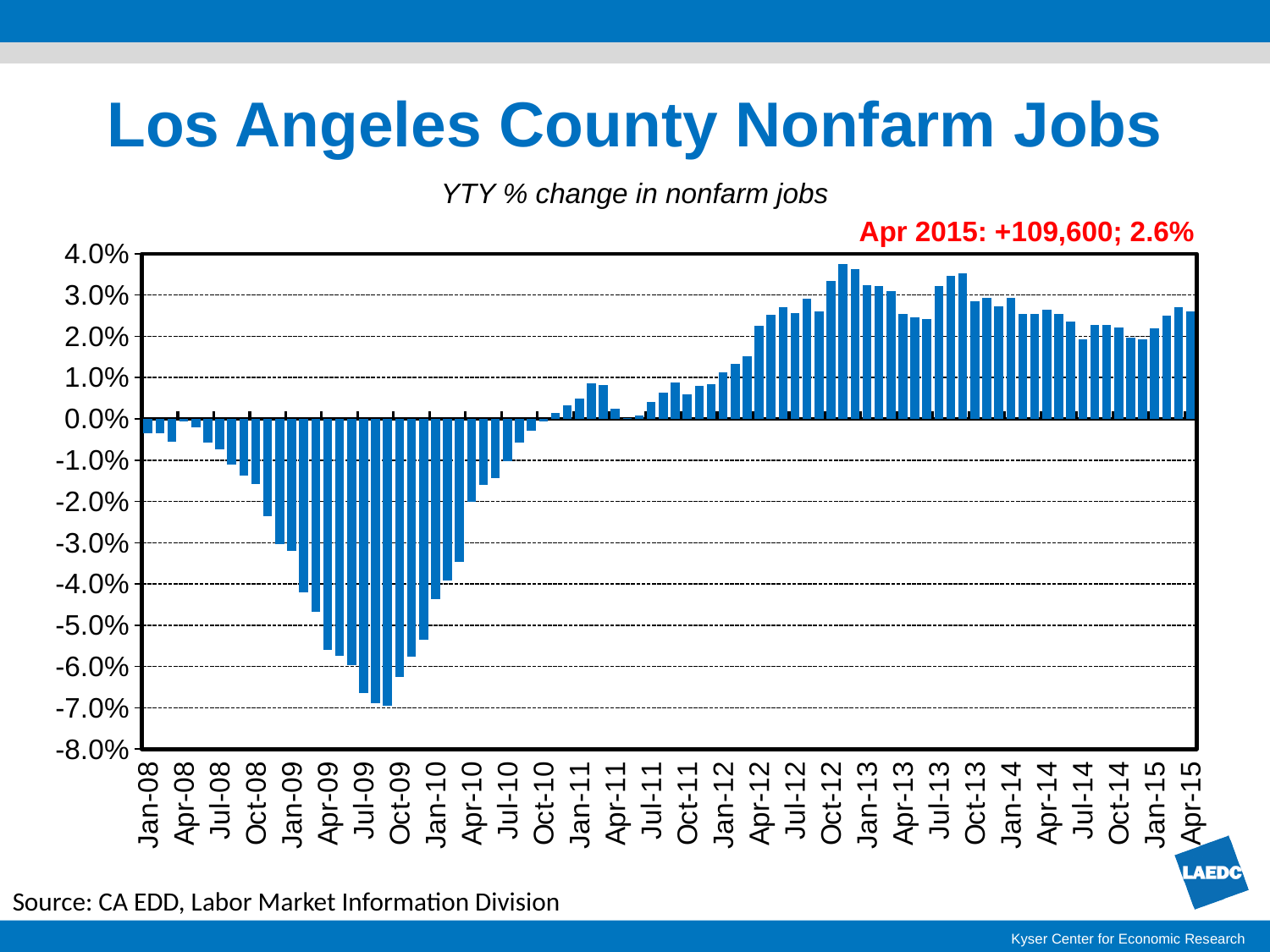
Do the values rise or fall from Jan-08 to Jul-09? fall How many nonfarm jobs were added year-to-year as of Apr 2015, according to the annotation? +109,600 Do the values rise or fall from Oct-09 to Jan-11? rise Is the value for Jan-14 greater or less than 2.0%? greater Is the value for Jul-09 greater or less than -5.0%? less What is the subtitle of the chart? YTY % change in nonfarm jobs Which is larger, the value for Jul-09 or the value for Jul-12? Jul-12 What kind of chart is shown on the slide? bar chart Is the value for Apr-09 greater or less than -4.0%? less In which year does the chart reach its lowest value? 2009 What is the YTY % change in nonfarm jobs for Apr 2015? 2.6%